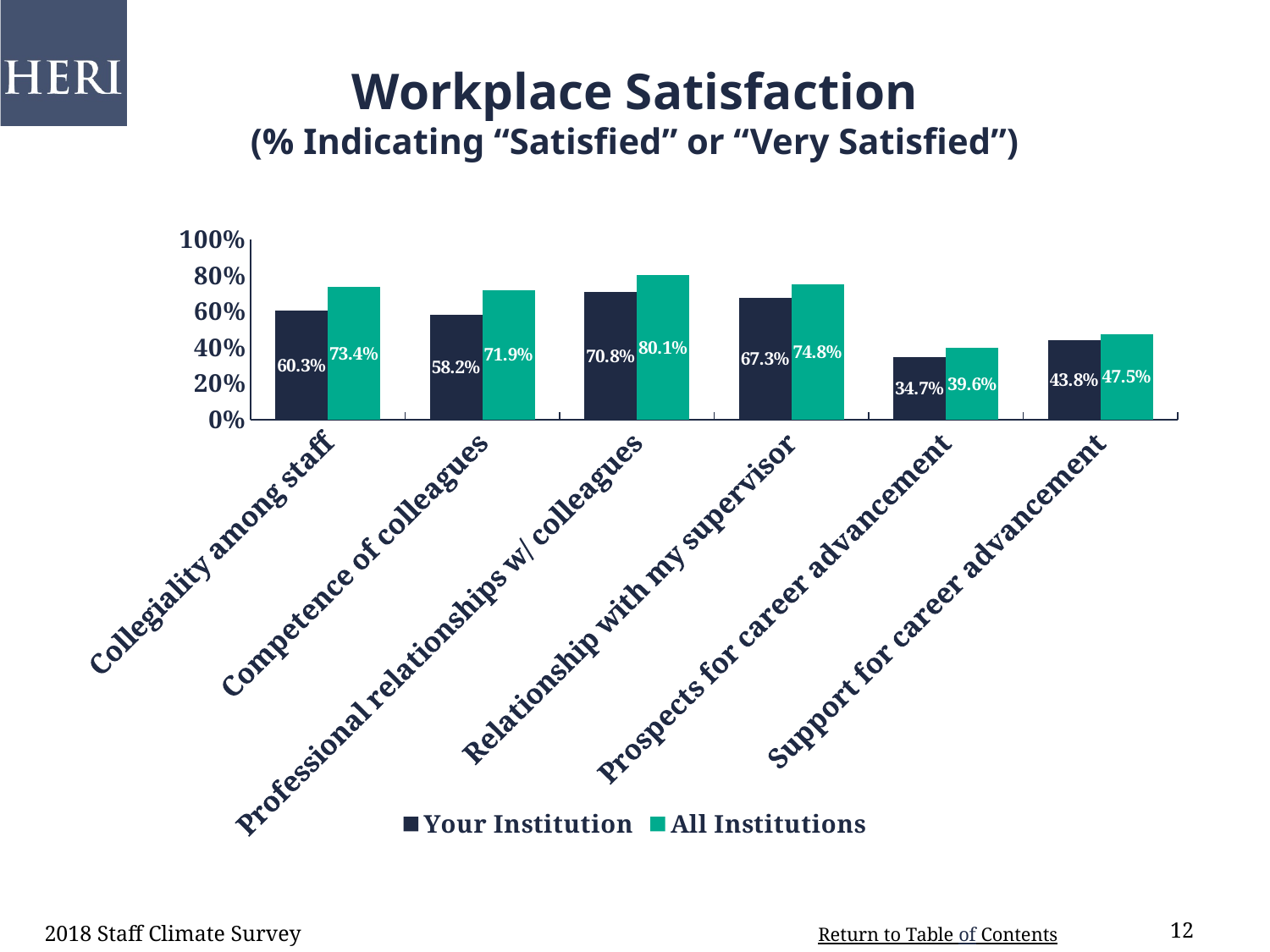
How many categories are shown on the x axis? 6 What is the difference between All Institutions and Your Institution for Competence of colleagues? 13.7% For Relationship with my supervisor, which is larger: Your Institution or All Institutions? All Institutions What is the value for Your Institution for Collegiality among staff? 60.3% How many series does the legend list? 2 Which category has the lowest value for Your Institution? Prospects for career advancement Which category has the highest value for All Institutions? Professional relationships w/ colleagues What kind of chart is shown on the slide? bar chart What is the title of the chart? Workplace Satisfaction What is the value for Your Institution for Prospects for career advancement? 34.7% Is the value for Your Institution for Support for career advancement greater or less than 60%? less What is the value for All Institutions for Professional relationships w/ colleagues? 80.1%